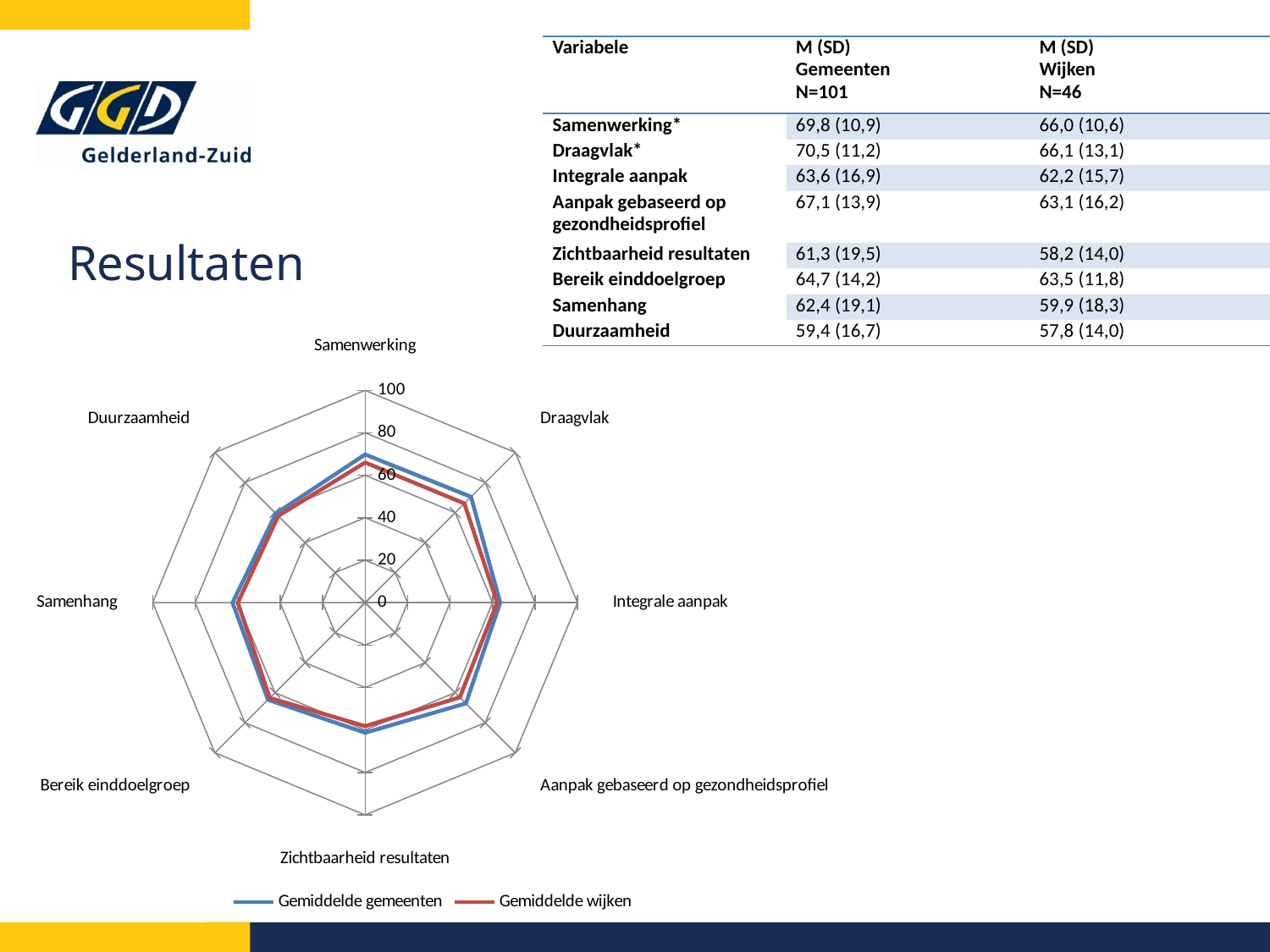
Which series is drawn in blue on the radar chart? Gemiddelde gemeenten According to the table on the slide, what is the difference between the mean for Draagvlak for Gemeenten and for Wijken? 4,4 How many categories (axes) does the radar chart have? 8 What is the highest value shown on the radar chart's axis scale? 100 How many series does the legend of the radar chart list? 2 Is the value for Samenwerking for Gemiddelde gemeenten greater or less than 60? greater For Draagvlak, which series has the larger value: Gemiddelde gemeenten or Gemiddelde wijken? Gemiddelde gemeenten According to the table on the slide, what is the mean (M) for Samenwerking for Gemeenten? 69,8 What kind of chart is shown on the slide? radar chart For Samenwerking, which series has the larger value: Gemiddelde gemeenten or Gemiddelde wijken? Gemiddelde gemeenten Is the value for Duurzaamheid for Gemiddelde wijken greater or less than 60? less Is the value for Draagvlak for Gemiddelde gemeenten greater or less than 80? less